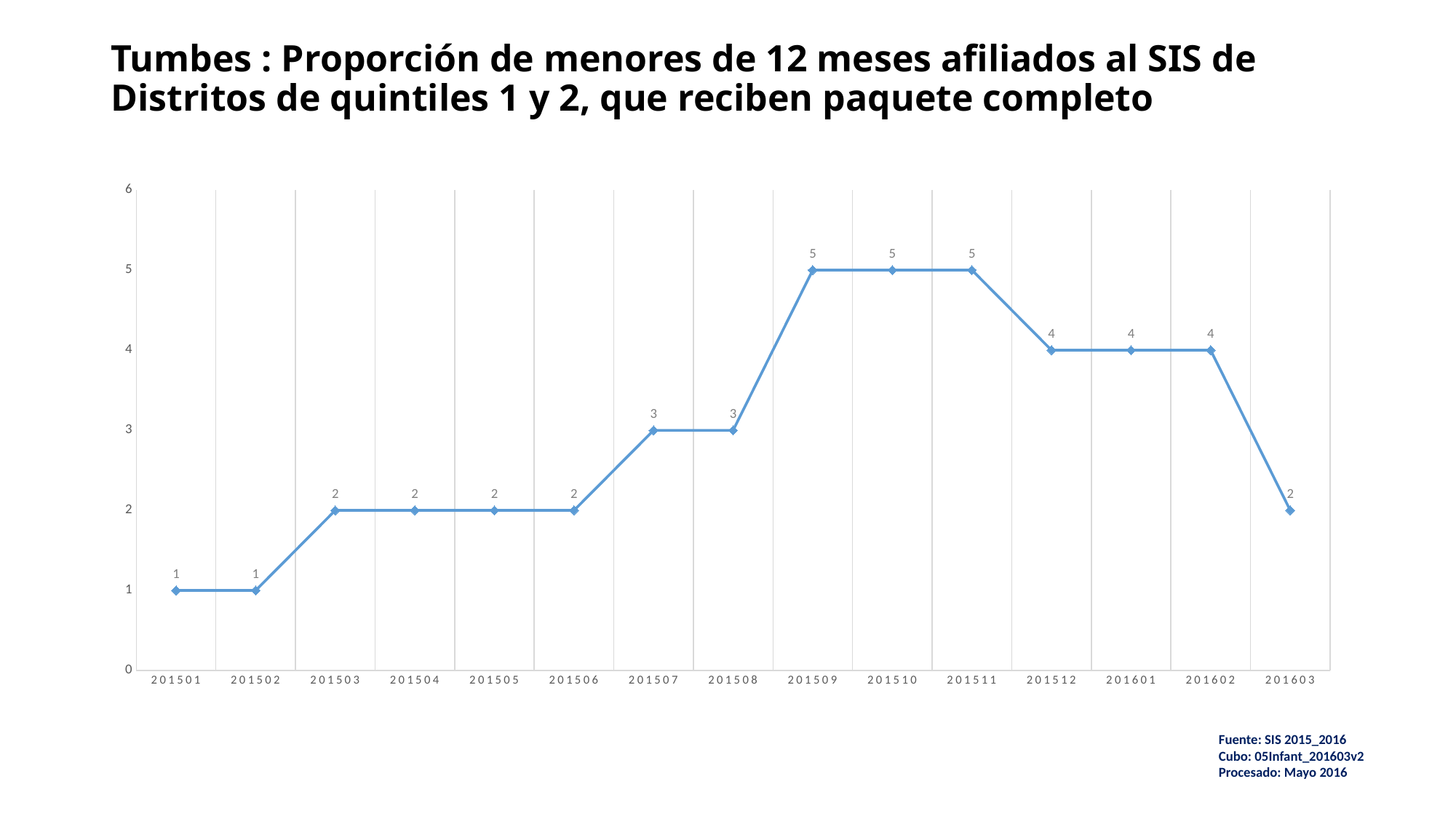
What is the value for 201509? 5 What is the value for 201512? 4 What is the highest value shown on the vertical axis? 6 Is the value for 201510 greater or less than 4? greater Which is larger, the value for 201507 or the value for 201506? 201507 What is the difference between the values for 201511 and 201512? 1 What is the difference between the values for 201602 and 201603? 2 How many data points are plotted on the chart? 15 What kind of chart is shown on the slide? line chart What is the value for 201501? 1 What is the value for 201603? 2 Do the values rise or fall from 201501 to 201509? rise